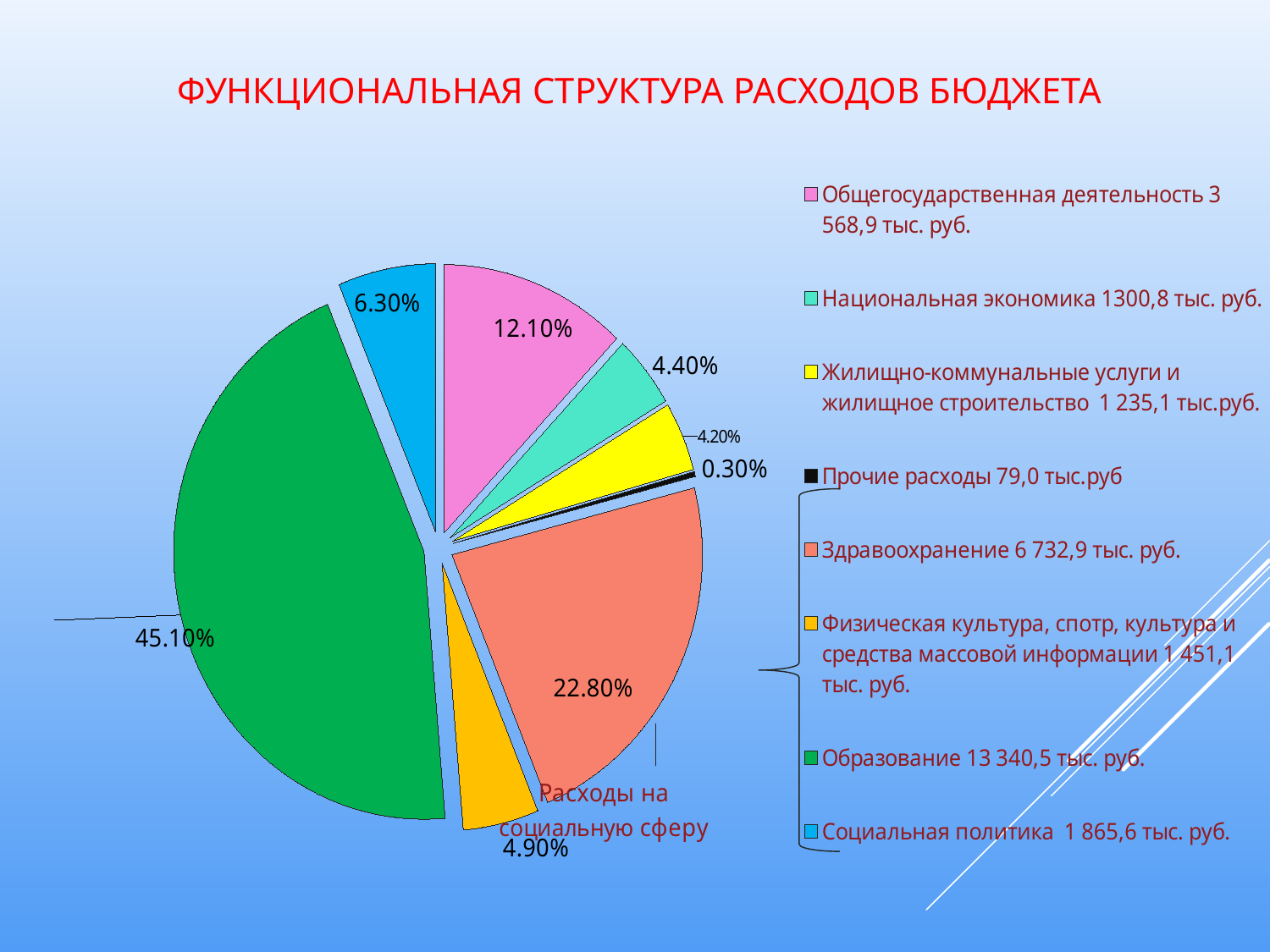
Which category has the smallest slice of the pie? Прочие расходы Which category has the largest slice of the pie? Образование What share of the pie does Здравоохранение take? 22.80% How many entries does the legend list? 8 What share of the pie does Социальная политика take? 6.30% How many slices does the pie chart have? 8 Which slice is larger, Национальная экономика or Социальная политика? Социальная политика What kind of chart is shown on the slide? pie chart What share of the pie does Общегосударственная деятельность take? 12.10% What is the difference in percentage points between the Образование slice and the Здравоохранение slice? 22.30%